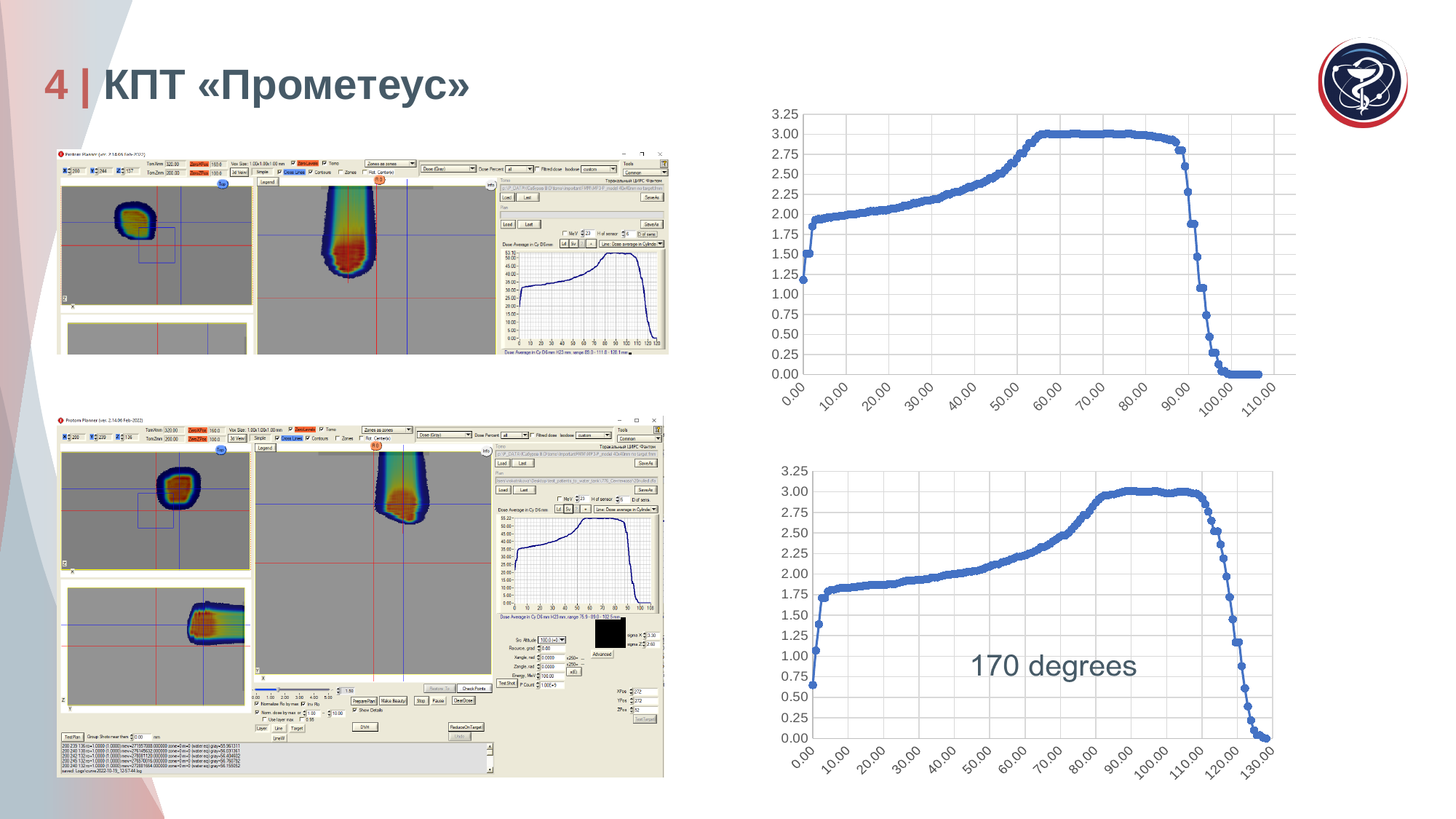
In the bottom right chart, is the value at x = 30.00 greater or less than 2.25? less In the top right chart, is the value at x = 100.00 greater or less than 0.50? less What kind of chart is the bottom chart on the right side of the slide? line chart In the top right chart, do the values rise or fall as x goes from 10.00 to 50.00? rise In the top right chart, what is the highest value shown on the y axis? 3.25 In the top right chart, which is larger: the value at x = 20.00 or the value at x = 80.00? the value at x = 80.00 In the top right chart, do the values rise or fall as x goes from 90.00 to 100.00? fall In the bottom right chart, is the value at x = 90.00 greater or less than 2.75? greater In the bottom right chart, what is the highest value shown on the x axis? 130.00 What kind of chart is the top chart on the right side of the slide? line chart